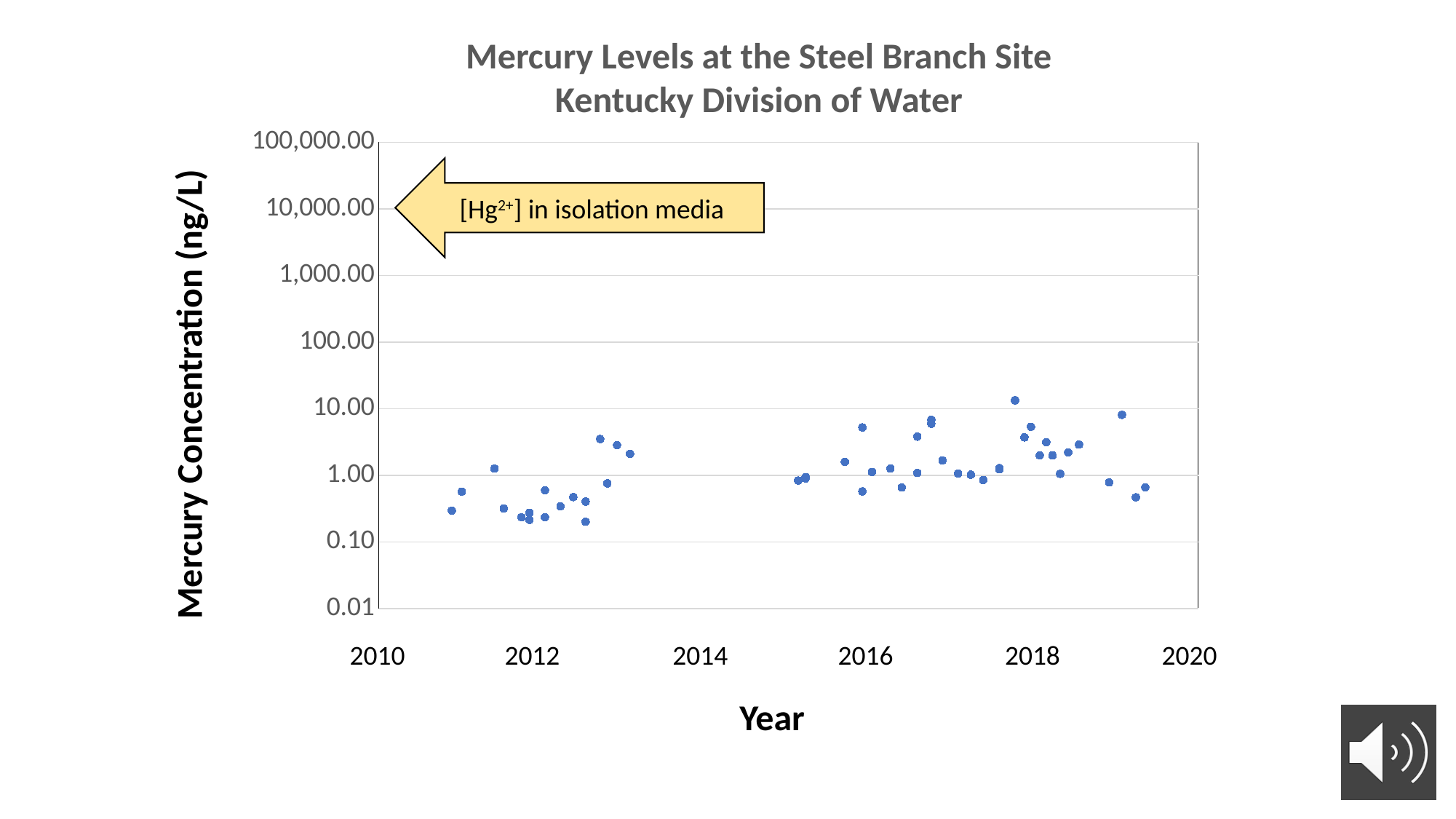
Is the earliest plotted point (around 2011) greater or less than 1.00 ng/L? less Is the point plotted near 2013.2 greater or less than 1.00 ng/L? greater Is the point plotted near 2019.2 greater or less than 1.00 ng/L? greater Which of the two clusters of points, 2011–2013 or 2016–2019, contains the lowest plotted value? 2011–2013 Which of the two clusters of points, 2011–2013 or 2016–2019, contains the highest plotted value? 2016–2019 What text is written inside the yellow arrow on the chart? [Hg2+] in isolation media What kind of chart is shown on the slide? Scatter plot Are the mercury concentrations in the 2016–2019 cluster generally higher or lower than those in the 2011–2013 cluster? higher What is the title of the chart? Mercury Levels at the Steel Branch Site Kentucky Division of Water